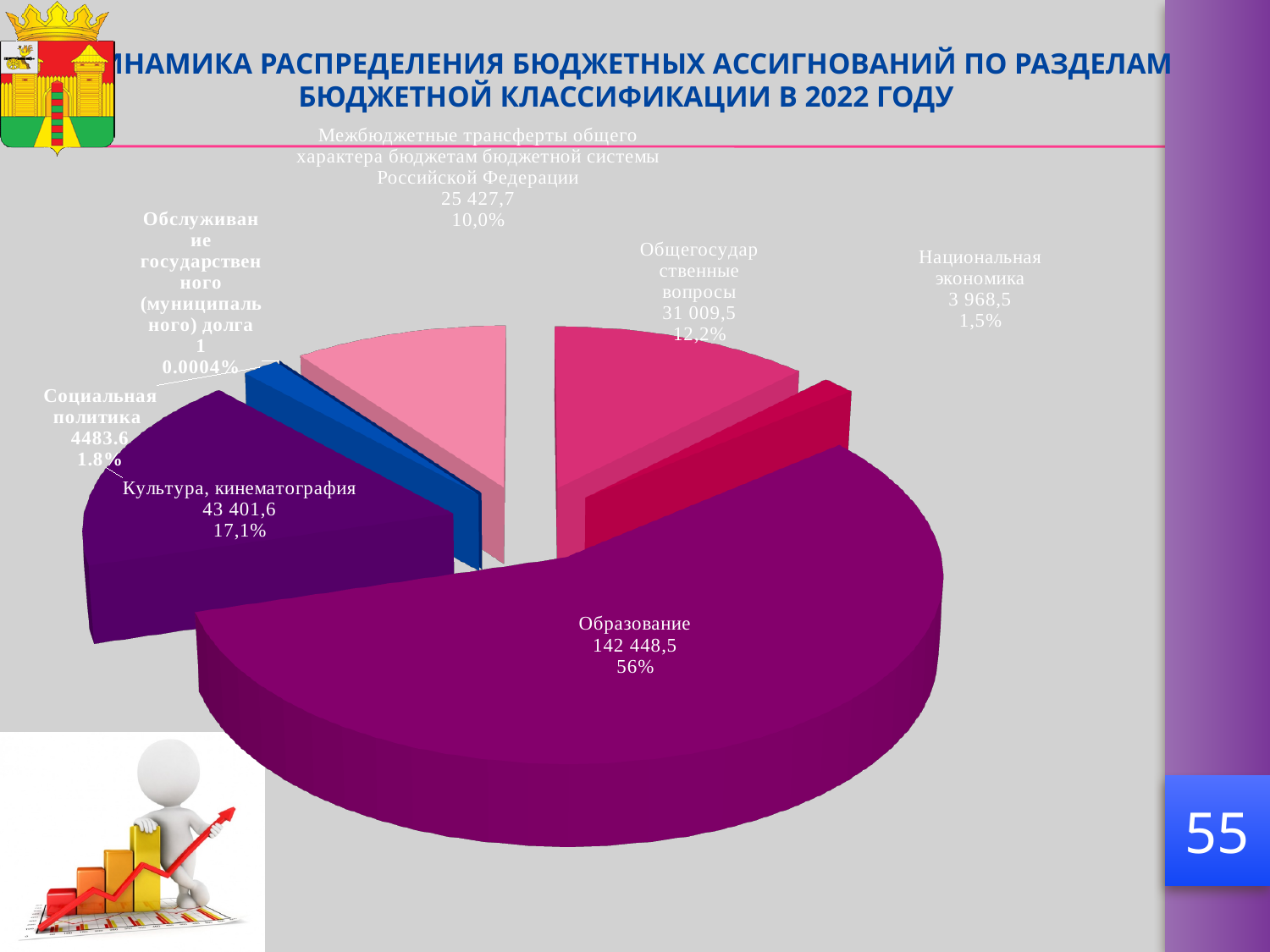
What share of the pie does Образование take? 56% What is the value for Образование? 142 448,5 How many categories are shown in the pie chart? 7 What percentage is shown for Общегосударственные вопросы? 12,2% What is the value for Культура, кинематография? 43 401,6 What percentage is shown for Межбюджетные трансферты общего характера бюджетам бюджетной системы Российской Федерации? 10,0% Which is larger, the value for Общегосударственные вопросы or the value for Социальная политика? Общегосударственные вопросы What is the value for Национальная экономика? 3 968,5 What kind of chart is shown on the slide? pie chart Which category has the smallest slice of the pie? Обслуживание государственного (муниципального) долга Which category has the largest slice of the pie? Образование What is the difference between the values for Образование and Культура, кинематография? 99 046,9